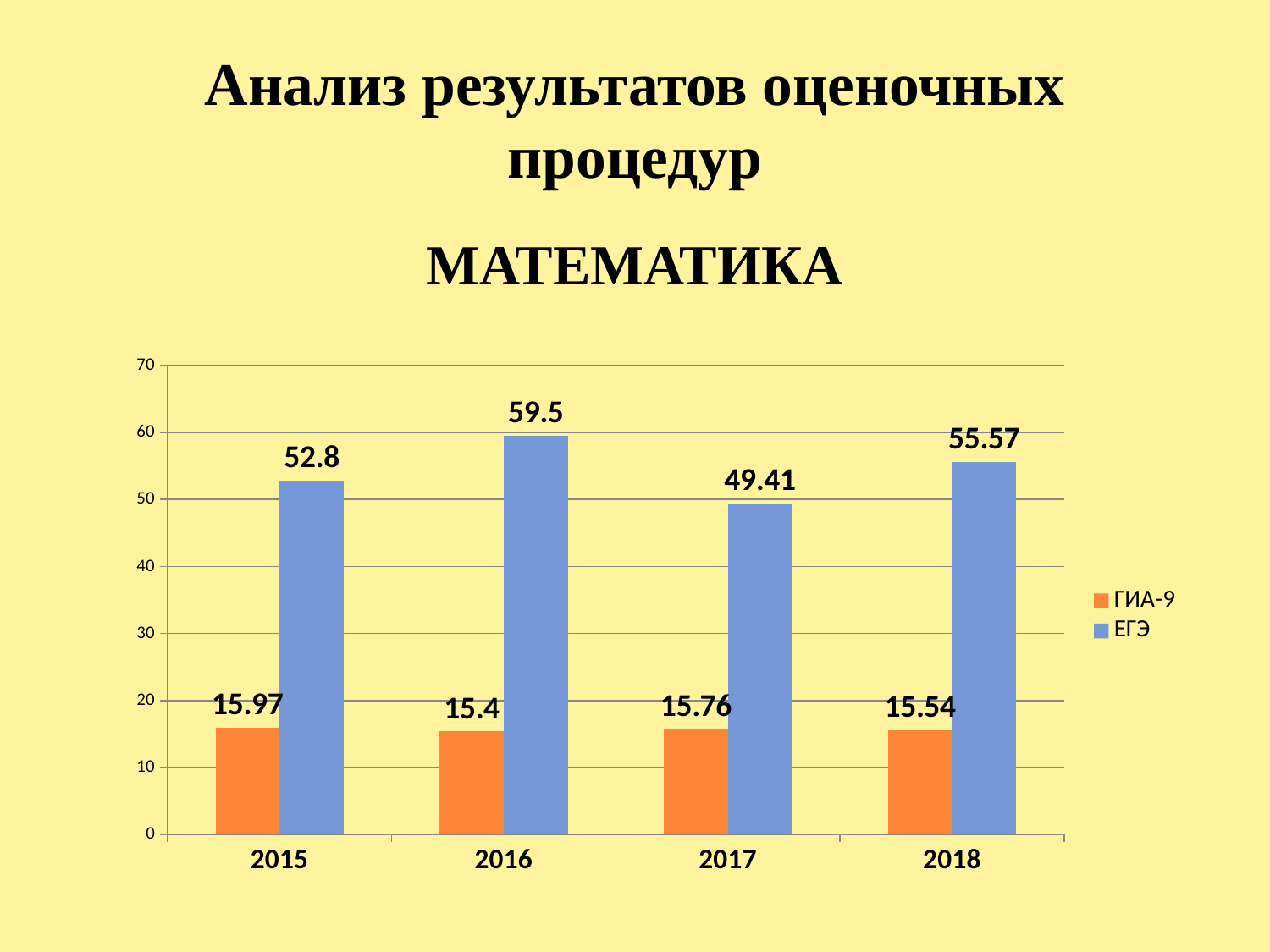
What is the ЕГЭ value for 2016? 59.5 What is the ЕГЭ value for 2017? 49.41 What is the difference between the ЕГЭ values for 2016 and 2017? 10.09 How many series does the legend list? 2 What is the ГИА-9 value for 2018? 15.54 What is the ГИА-9 value for 2015? 15.97 What kind of chart is shown on the slide? Bar chart Which is larger, the ЕГЭ value for 2015 or for 2018? 2018 How many years are shown on the x axis? 4 In which year is the ЕГЭ value lowest? 2017 Which colour represents the ЕГЭ series? Blue In which year is the ЕГЭ value highest? 2016